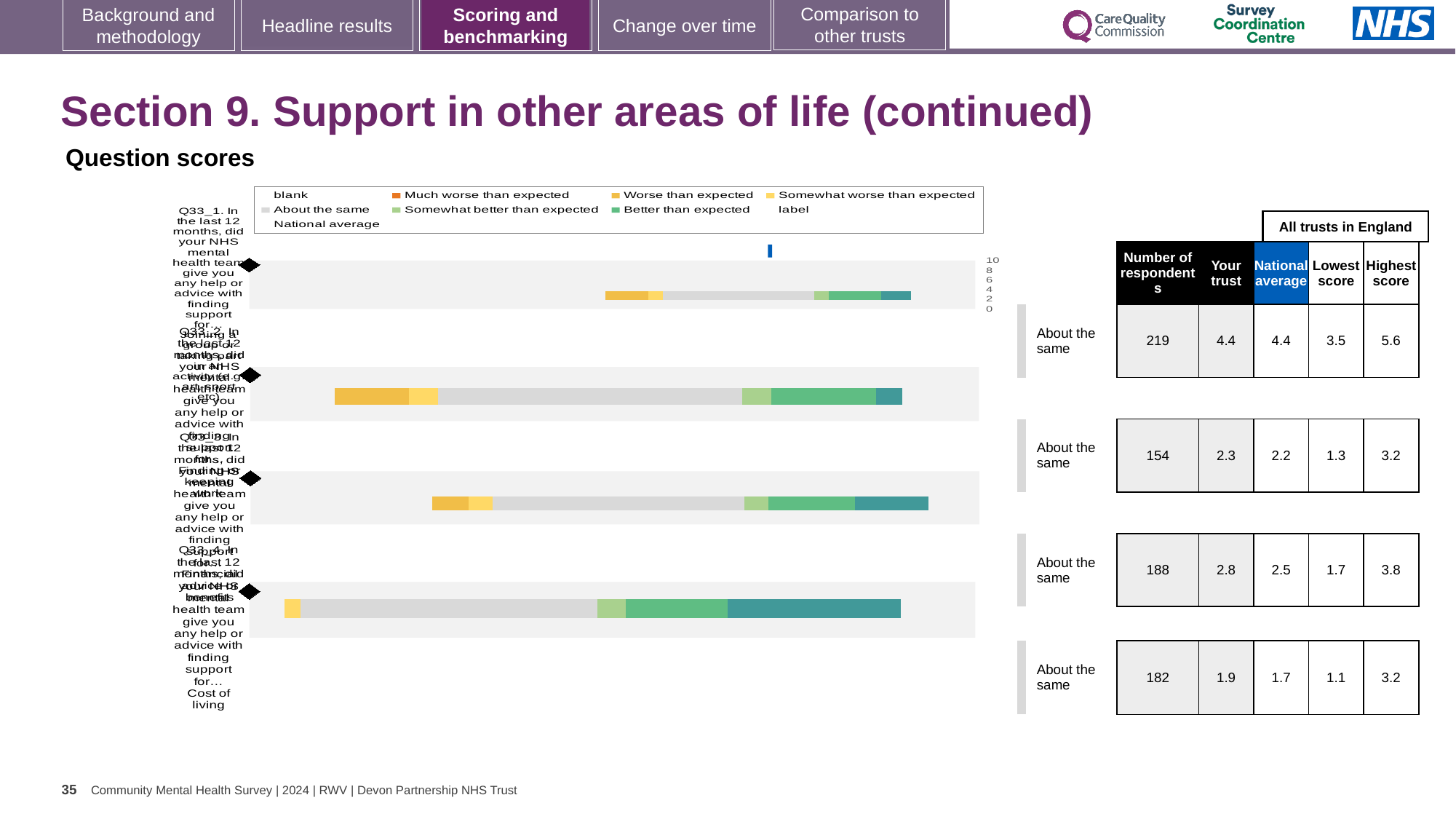
What benchmark label is shown beside each of the four bars in the chart? About the same In the table next to the chart, what is the 'Your trust' score for the first bar (Q33_1)? 4.4 In the table next to the chart, which bar has the lowest 'Your trust' score? Q33_4 (fourth bar) In the table next to the chart, is the 'Your trust' score for the second bar (Q33_2) larger or smaller than its national average? larger Which legend entry is shown in dark orange? Much worse than expected In the table next to the chart, what is the number of respondents for the first bar (Q33_1)? 219 In the table next to the chart, what is the difference between 'Your trust' and 'National average' for the third bar (Q33_3)? 0.3 What kind of chart is shown on the slide? bar chart How many stacked bars (questions) are plotted in the chart? 4 How many entries does the chart legend list? 9 In the table next to the chart, what is the highest score for the fourth bar (Q33_4)? 3.2